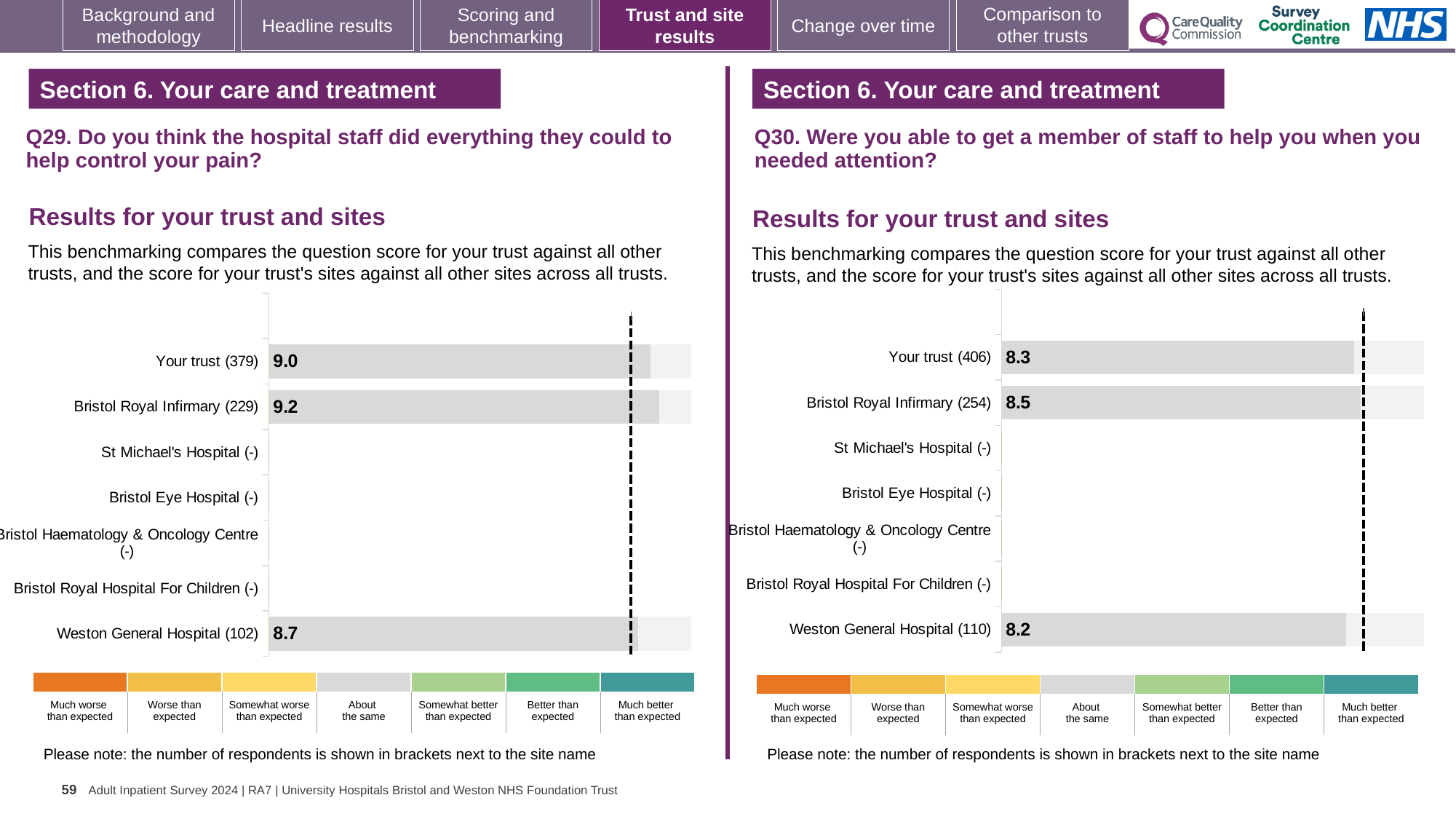
In the Q29 chart (left), what is the difference between the scores for Bristol Royal Infirmary and Weston General Hospital? 0.5 In the Q30 chart (right), what is the score for Your trust (406)? 8.3 In the Q29 chart (left), what is the score for Weston General Hospital (102)? 8.7 In the Q29 chart (left), which site has the highest score? Bristol Royal Infirmary (229) In the Q29 chart (left), what is the score for Bristol Royal Infirmary (229)? 9.2 How many site categories are listed on the y axis of the Q29 chart (left)? 7 In the Q30 chart (right), what is the score for Weston General Hospital (110)? 8.2 In the Q30 chart (right), what is the score for Bristol Royal Infirmary (254)? 8.5 In the Q30 chart (right), which is larger: the score for Your trust or for Bristol Royal Infirmary? Bristol Royal Infirmary What kind of chart is used for the Q30 results (right)? Bar chart In the Q30 chart (right), which site has the lowest score? Weston General Hospital (110) In the Q29 chart (left), what is the score for Your trust (379)? 9.0